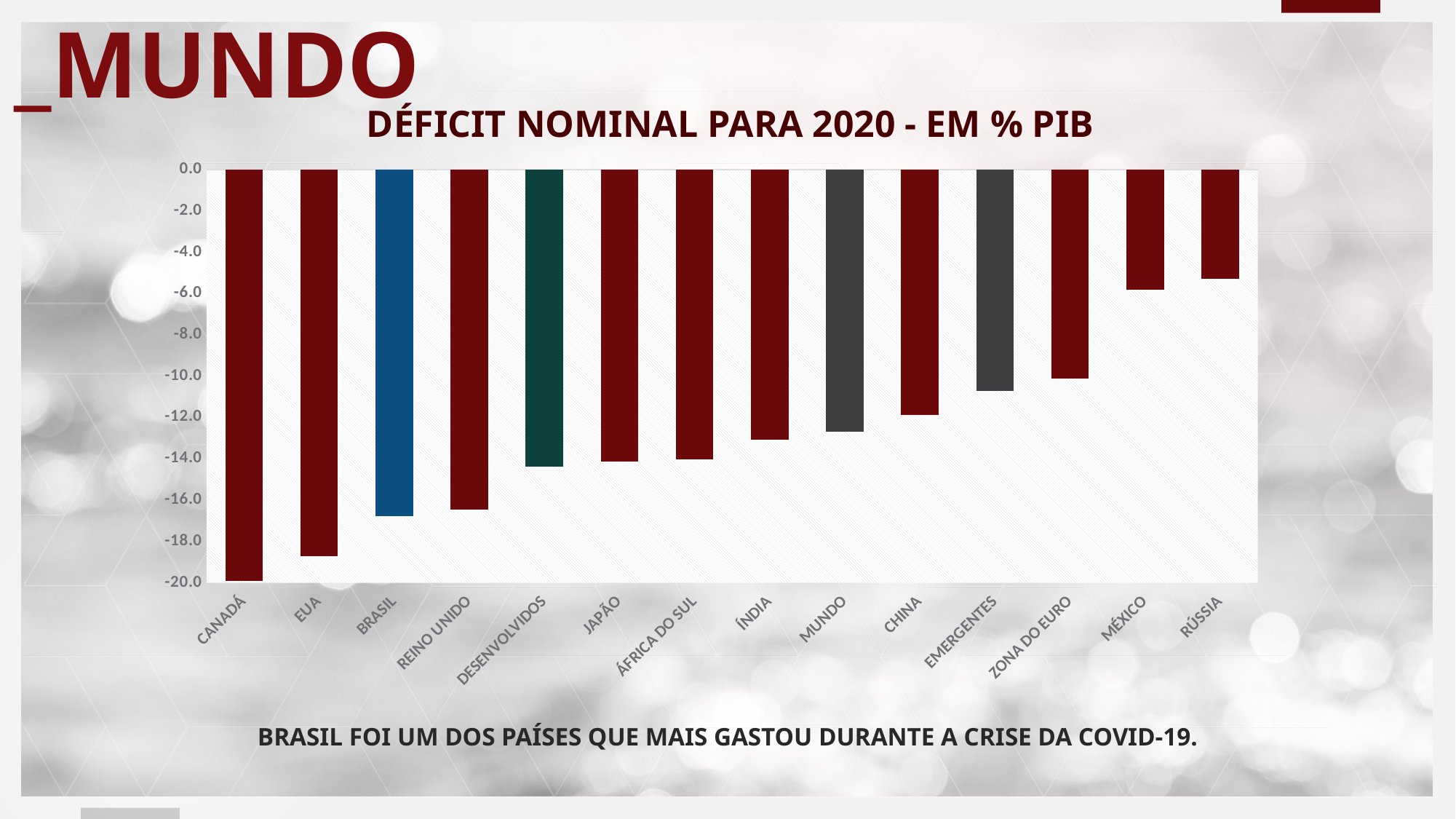
What kind of chart is shown on the slide? bar chart Which country or group has the smallest nominal deficit (the shortest bar) on the chart? Rússia How many countries or groups are plotted on the chart? 14 Which country's bar is coloured blue on the chart? Brasil Is the value for Brasil greater or less than -16.0? less What is the title of the chart? DÉFICIT NOMINAL PARA 2020 - EM % PIB Moving from left to right along the x axis, do the deficits get larger or smaller? smaller Which country or group has the largest nominal deficit (the longest bar) on the chart? Canadá Which has the larger deficit (longer bar), Brasil or Reino Unido? Brasil Is the value for EUA greater or less than -18.0? less Which has the larger deficit (longer bar), China or Mundo? Mundo Is the value for México greater or less than -8.0? greater